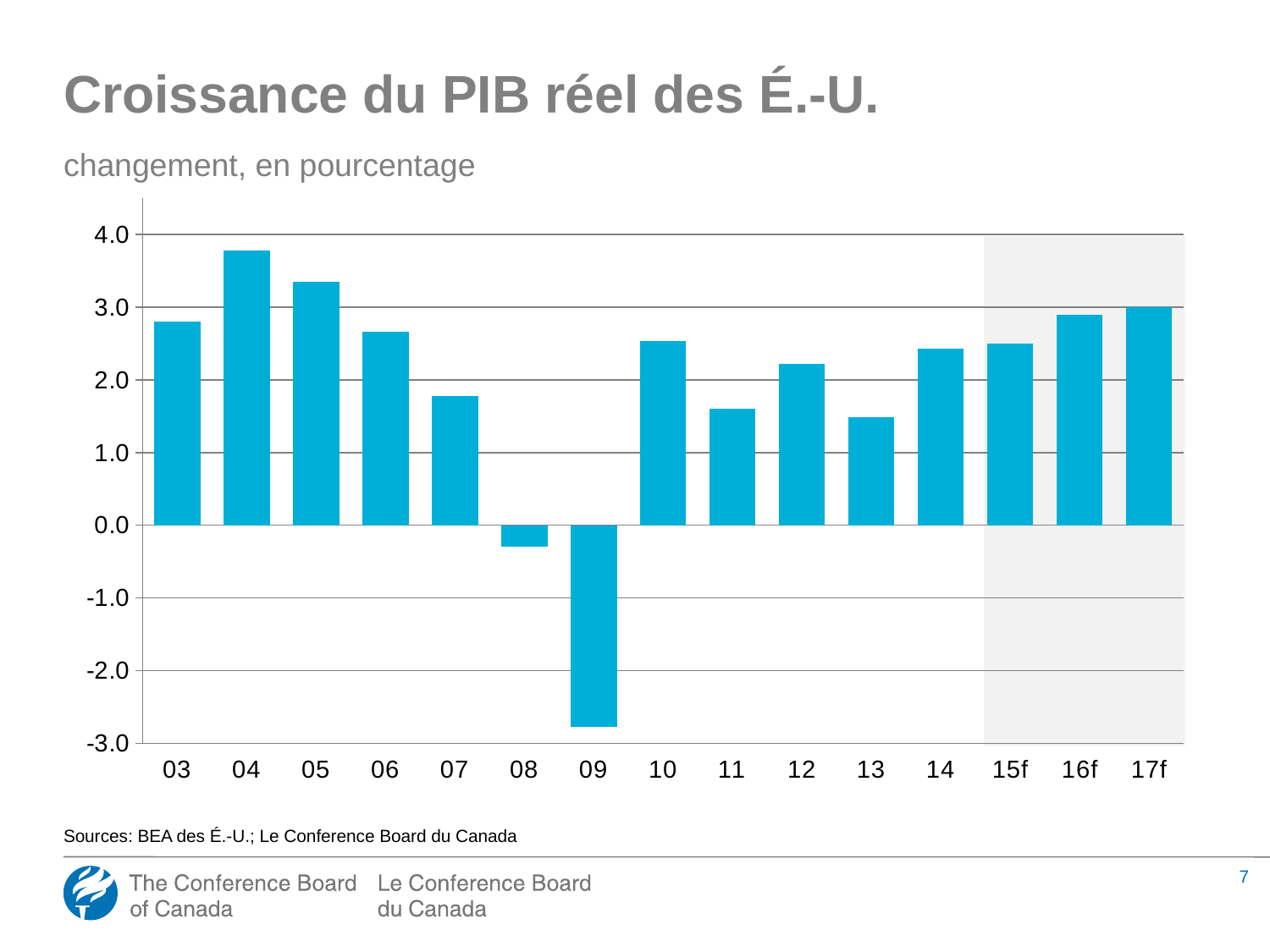
Is the value for 13 greater or less than 1.0? greater Is the value for 04 greater or less than 3.0? greater Which is larger, the value for 08 or the value for 09? 08 Is the value for 07 greater or less than 2.0? less Which is larger, the value for 04 or the value for 05? 04 Which year has the lowest real GDP growth in the chart? 09 How many years (categories) are shown on the x axis? 15 What kind of chart is shown on the slide? bar chart How many years show negative GDP growth? 2 Do the values rise or fall from 13 to 17f? rise Which year has the highest real GDP growth in the chart? 04